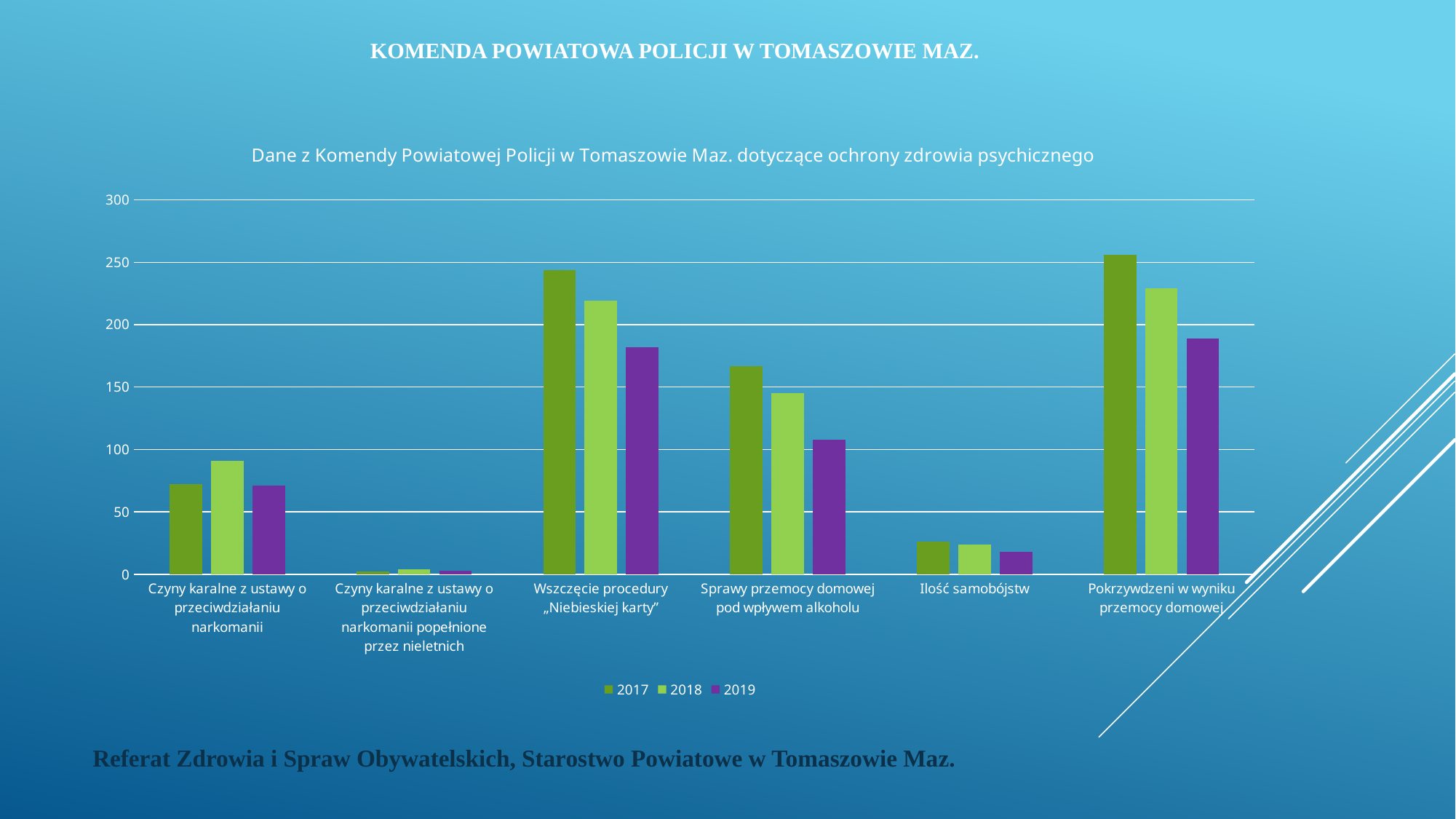
Is the 2019 value for Pokrzywdzeni w wyniku przemocy domowej greater or less than 150? greater Is the 2017 value for Wszczęcie procedury „Niebieskiej karty” greater or less than 200? greater Which category has the highest value for 2017? Pokrzywdzeni w wyniku przemocy domowej Is the 2019 value for Sprawy przemocy domowej pod wpływem alkoholu greater or less than 150? less What kind of chart is shown on the slide? bar chart Which years are listed in the chart legend? 2017, 2018, 2019 Which category has the lowest value for 2018? Czyny karalne z ustawy o przeciwdziałaniu narkomanii popełnione przez nieletnich Do the values for Wszczęcie procedury „Niebieskiej karty” rise or fall from 2017 to 2019? fall For Pokrzywdzeni w wyniku przemocy domowej, which year has the larger value, 2017 or 2019? 2017 What is the title of the chart? Dane z Komendy Powiatowej Policji w Tomaszowie Maz. dotyczące ochrony zdrowia psychicznego How many series does the legend list? 3 How many categories are shown on the x axis? 6